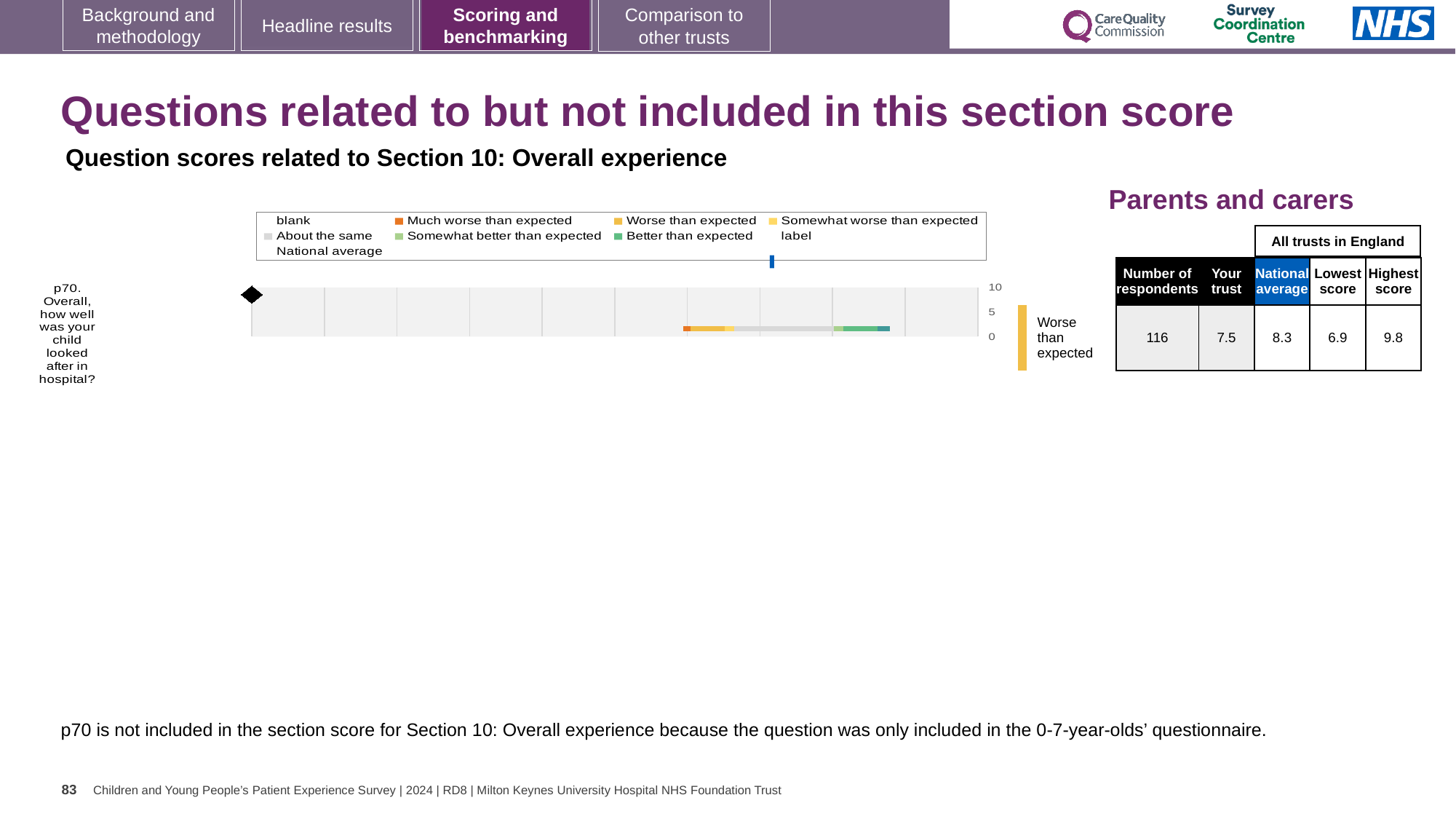
What is the label of the question plotted in the chart? p70. Overall, how well was your child looked after in hospital? In the table next to the chart, what is the Lowest score among all trusts in England for p70? 6.9 In the table next to the chart, what is the 'Your trust' score for p70? 7.5 What is the highest value shown on the chart's vertical axis? 10 Which is larger for p70: the 'Your trust' score or the National average? National average What kind of chart is shown on the slide? bar chart What is the difference between the National average (8.3) and the 'Your trust' score (7.5) for p70? 0.8 How many survey questions are plotted in the chart? 1 According to the label to the right of the chart, which benchmark category does the trust's result for p70 fall into? Worse than expected In the table next to the chart, what is the National average score for p70? 8.3 In the table next to the chart, what is the Highest score among all trusts in England for p70? 9.8 In the table next to the chart, how many respondents answered p70? 116